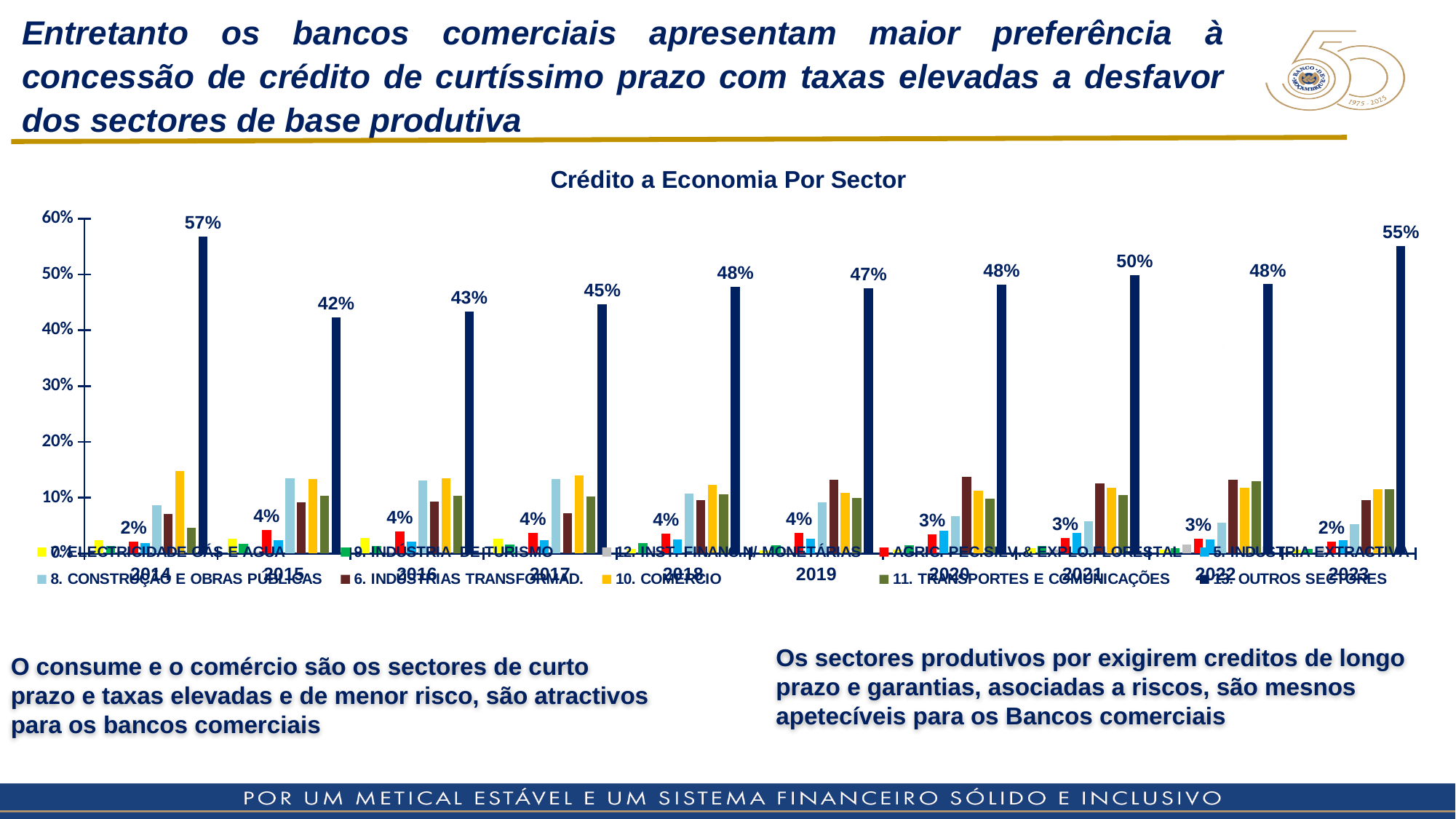
What is the title of the chart? Crédito a Economia Por Sector Is the value of the yellow bar (10. COMÉRCIO) for 2014 greater or less than 20%? less What value is labelled on the tallest (dark navy) bar for 2014? 57% What value is labelled on the red bar (1. AGRIC. PEC.SILV. & EXPLO.FLORESTAL) for 2014? 2% What kind of chart is shown on the slide? Bar chart Which year has the larger dark navy bar value, 2021 or 2022? 2021 What is the difference between the dark navy bar values for 2014 and 2015? 15 percentage points How many years are shown along the x axis of the chart? 10 How many series does the chart's legend list? 10 In which year is the dark navy bar the lowest? 2015 What value is labelled on the tallest (dark navy) bar for 2023? 55% In which year is the dark navy bar the highest? 2014